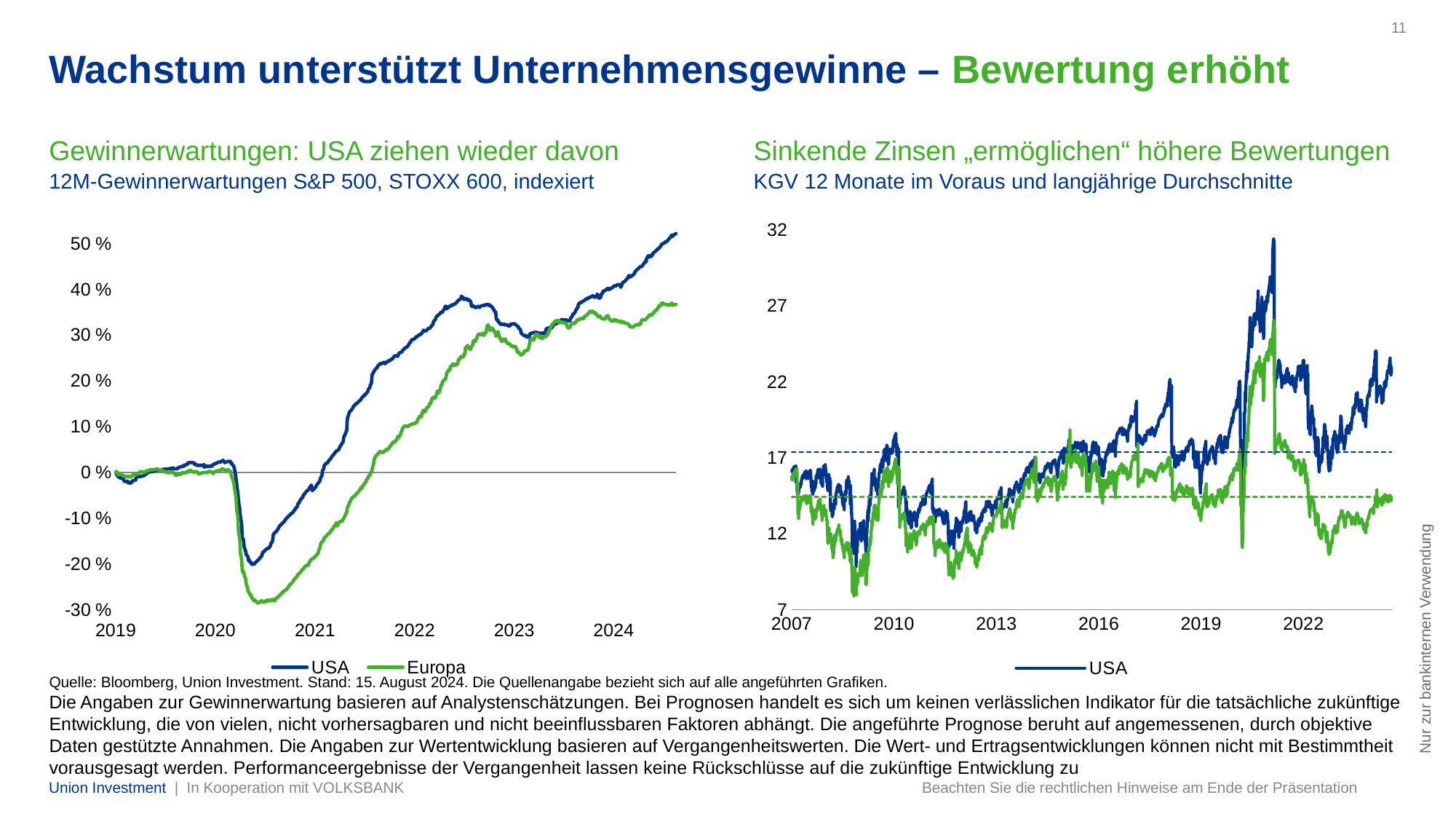
In the left chart, is the value for USA at the end of 2024 greater or less than 40 %? greater Which series are listed in the legend of the left chart? USA and Europa What kind of chart is the left chart, 'Gewinnerwartungen: USA ziehen wieder davon'? line chart How many series does the legend of the left chart list? 2 In the left chart, is the lowest value for Europa in 2020 greater or less than -20 %? less In the left chart, do the values for USA generally rise or fall from 2021 to 2024? rise In the left chart, which series is higher at the end of 2024, USA or Europa? USA In the left chart, is the value for Europa at the end of 2024 greater or less than 30 %? greater In the left chart, which series fell lower during the 2020 dip, USA or Europa? Europa How many series does the legend of the right chart, 'Sinkende Zinsen „ermöglichen“ höhere Bewertungen', list? 1